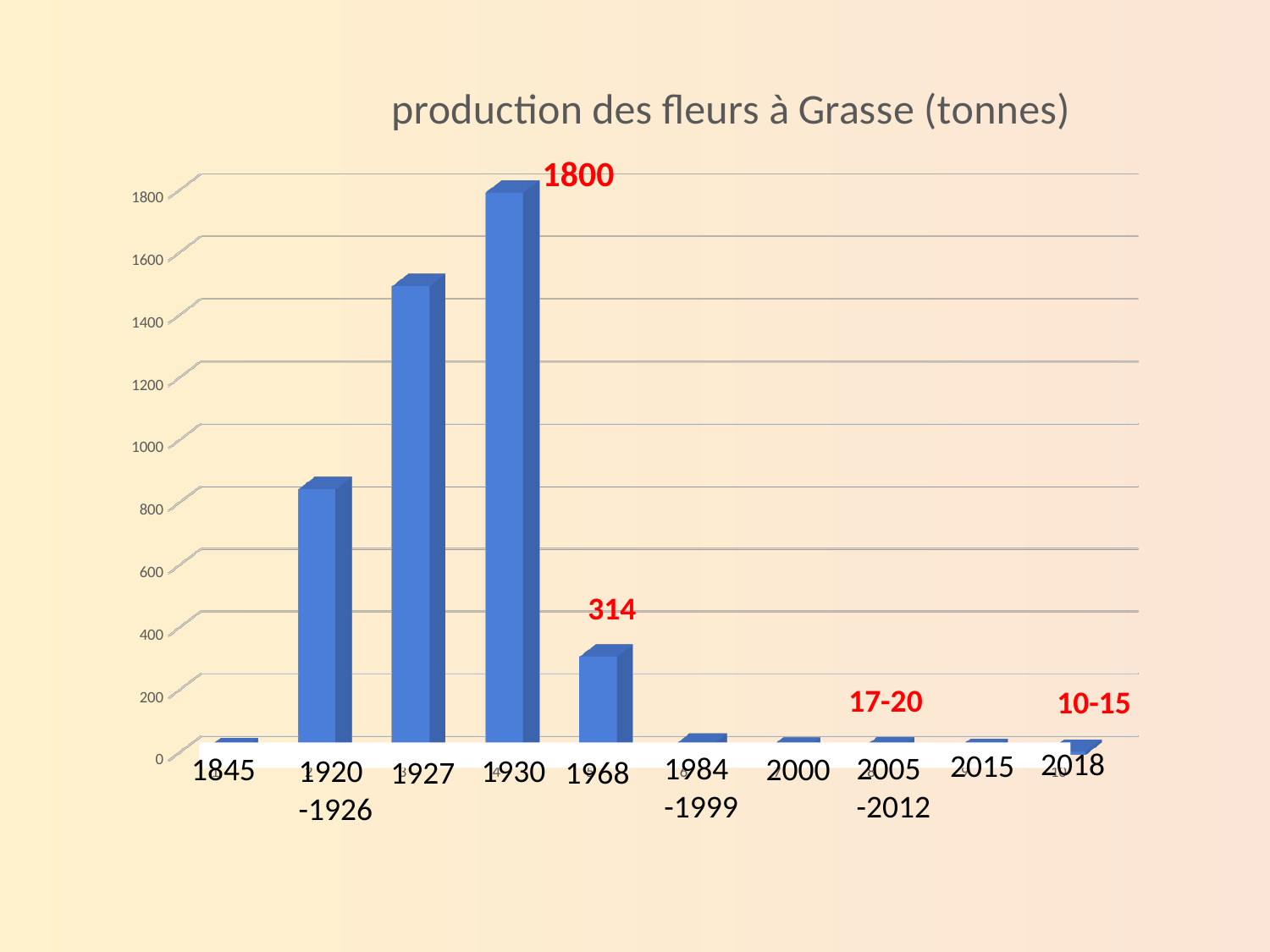
What is the value labelled for 2018? 10-15 What is the difference between the values for 1930 and 1968? 1486 Which category has the highest production? 1930 Which is larger, the value for 1927 or the value for 1920-1926? 1927 Is the value for 1920-1926 greater or less than 1000? less What is the value labelled for 2005-2012? 17-20 How many categories are shown on the x axis? 10 What is the value for 1930? 1800 What kind of chart is this? bar chart What is the title of the chart? production des fleurs à Grasse (tonnes) What is the value for 1968? 314 Is the value for 1927 greater or less than 1400? greater